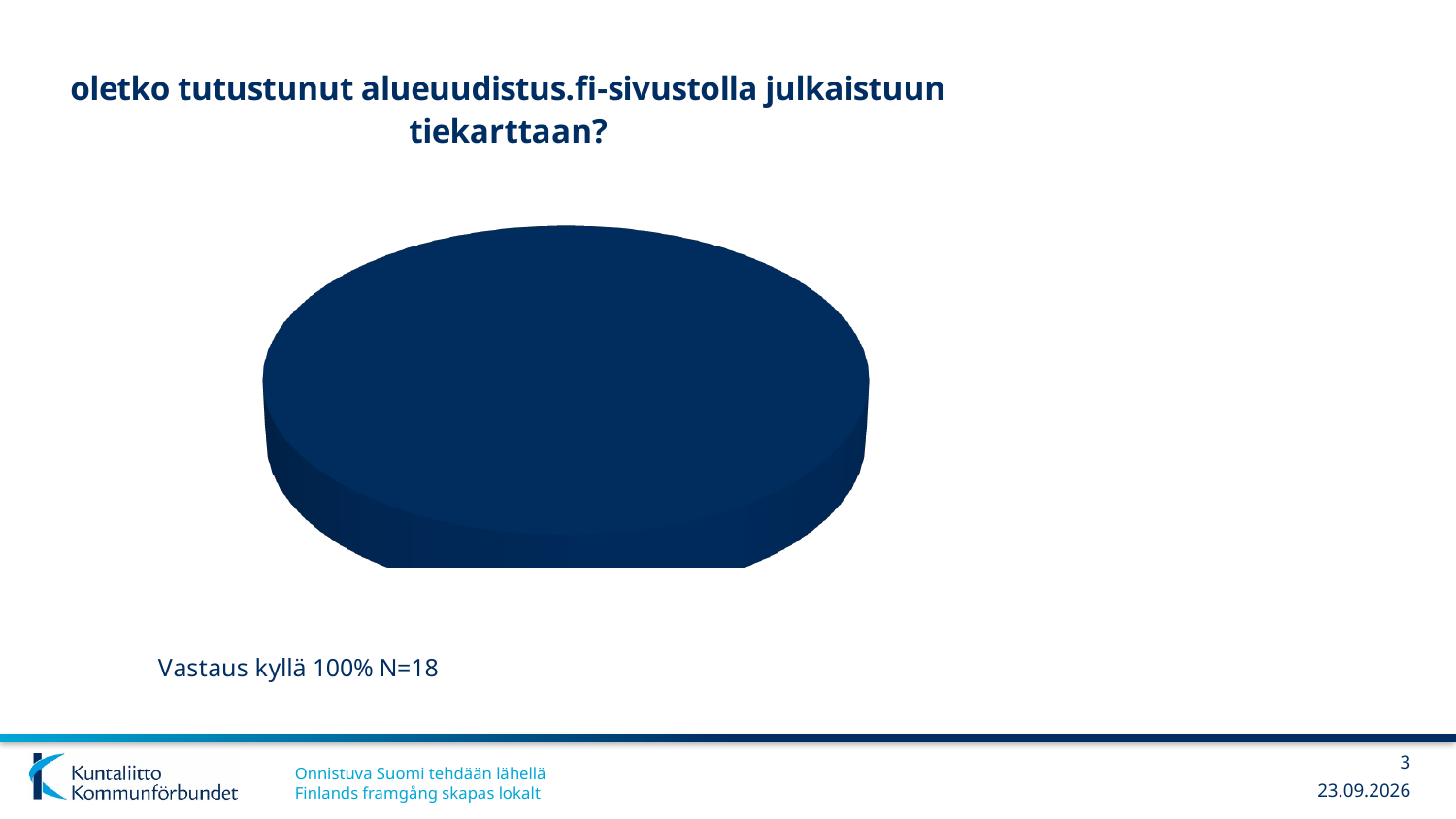
How many slices does the pie chart contain? 1 What share of the pie does the answer "kyllä" represent? 100% What kind of chart is shown on the slide? pie chart What colour is the single slice of the pie chart? dark blue Which answer option accounts for the whole pie chart? kyllä What question is the pie chart about, according to the slide title? oletko tutustunut alueuudistus.fi-sivustolla julkaistuun tiekarttaan? What is the number of respondents (N) stated below the pie chart? N=18